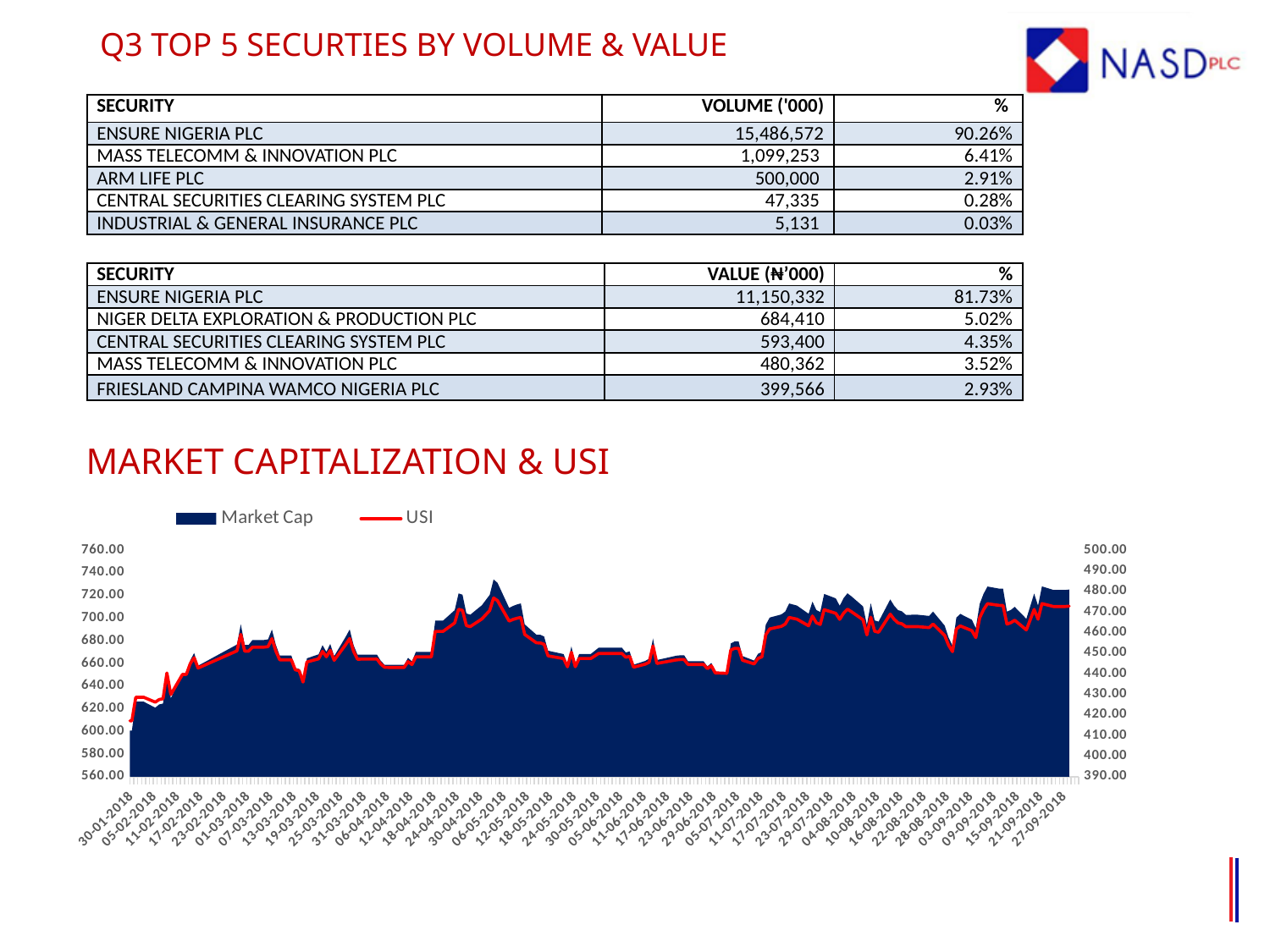
What kind of chart is the MARKET CAPITALIZATION & USI chart? An area chart with a line overlay In the MARKET CAPITALIZATION & USI chart, is the Market Cap value at 30-01-2018 greater or less than 640.00? less How many series does the legend of the MARKET CAPITALIZATION & USI chart list? 2 In the MARKET CAPITALIZATION & USI chart, which series is drawn as a red line? USI Which two series are shown in the legend of the MARKET CAPITALIZATION & USI chart? Market Cap and USI In the MARKET CAPITALIZATION & USI chart, is the Market Cap value higher at 27-09-2018 or at 30-01-2018? 27-09-2018 In the MARKET CAPITALIZATION & USI chart, is the Market Cap value at 29-06-2018 greater or less than 700.00? less In the MARKET CAPITALIZATION & USI chart, is the USI value at 27-09-2018 greater or less than 460.00? greater In the MARKET CAPITALIZATION & USI chart, does Market Cap overall rise or fall from 30-01-2018 to 27-09-2018? Rise In the MARKET CAPITALIZATION & USI chart, is the USI value higher at 06-05-2018 or at 29-06-2018? 06-05-2018